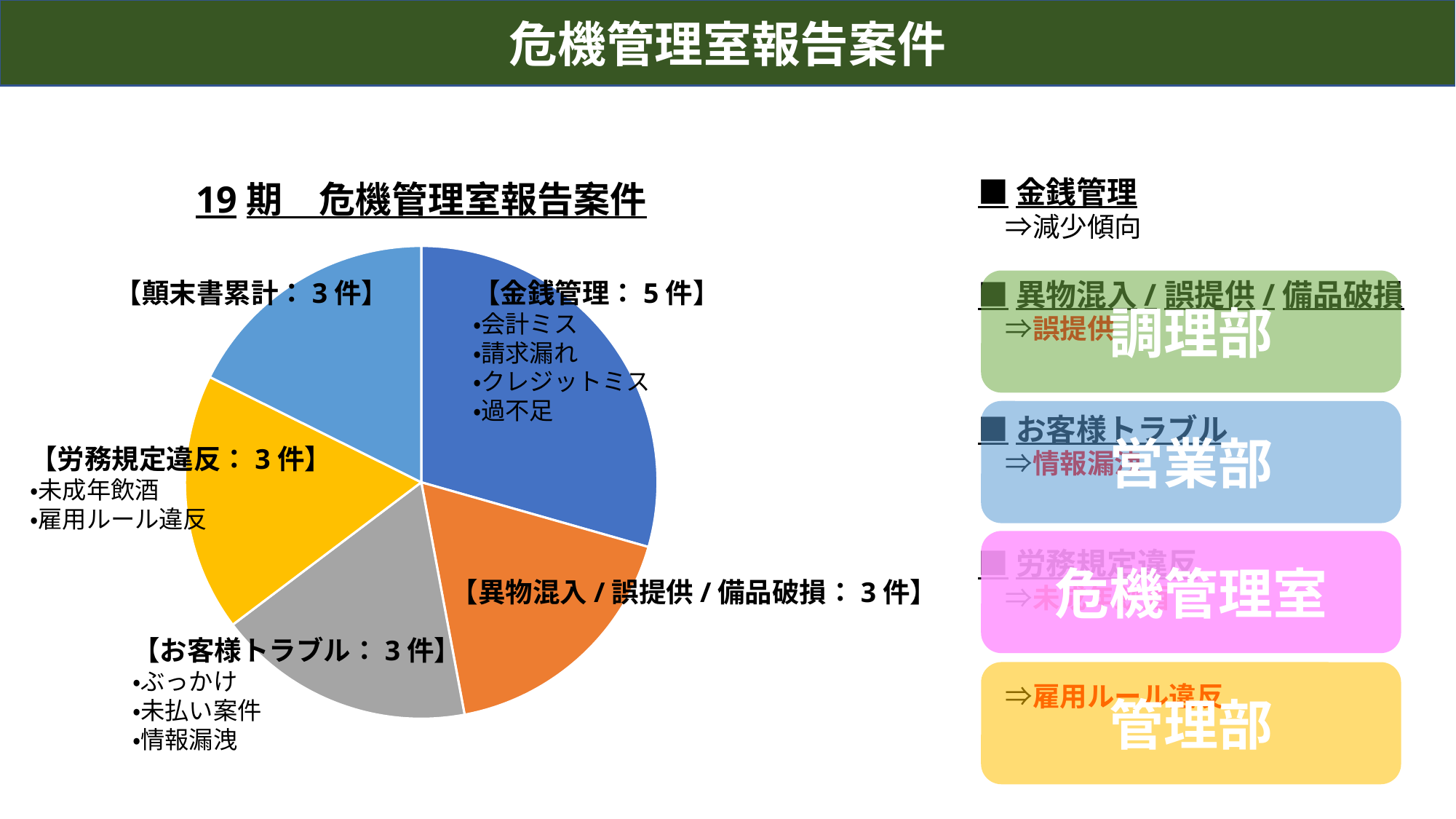
What is the difference in cases between 金銭管理 and 異物混入/誤提供/備品破損? 2件 What is the title of the pie chart? 19期 危機管理室報告案件 What is the total number of cases across all slices of the pie chart? 17件 How many categories (slices) does the pie chart have? 5 How many cases are reported for 労務規定違反 in the pie chart? 3件 What colour is the 労務規定違反 slice in the pie chart? yellow How many cases are reported for お客様トラブル in the pie chart? 3件 Which has more cases, 金銭管理 or お客様トラブル? 金銭管理 How many cases are reported for 金銭管理 in the pie chart? 5件 How many cases are reported for 顛末書累計 in the pie chart? 3件 What kind of chart is shown on the slide? pie chart Which category has the largest number of cases in the pie chart? 金銭管理